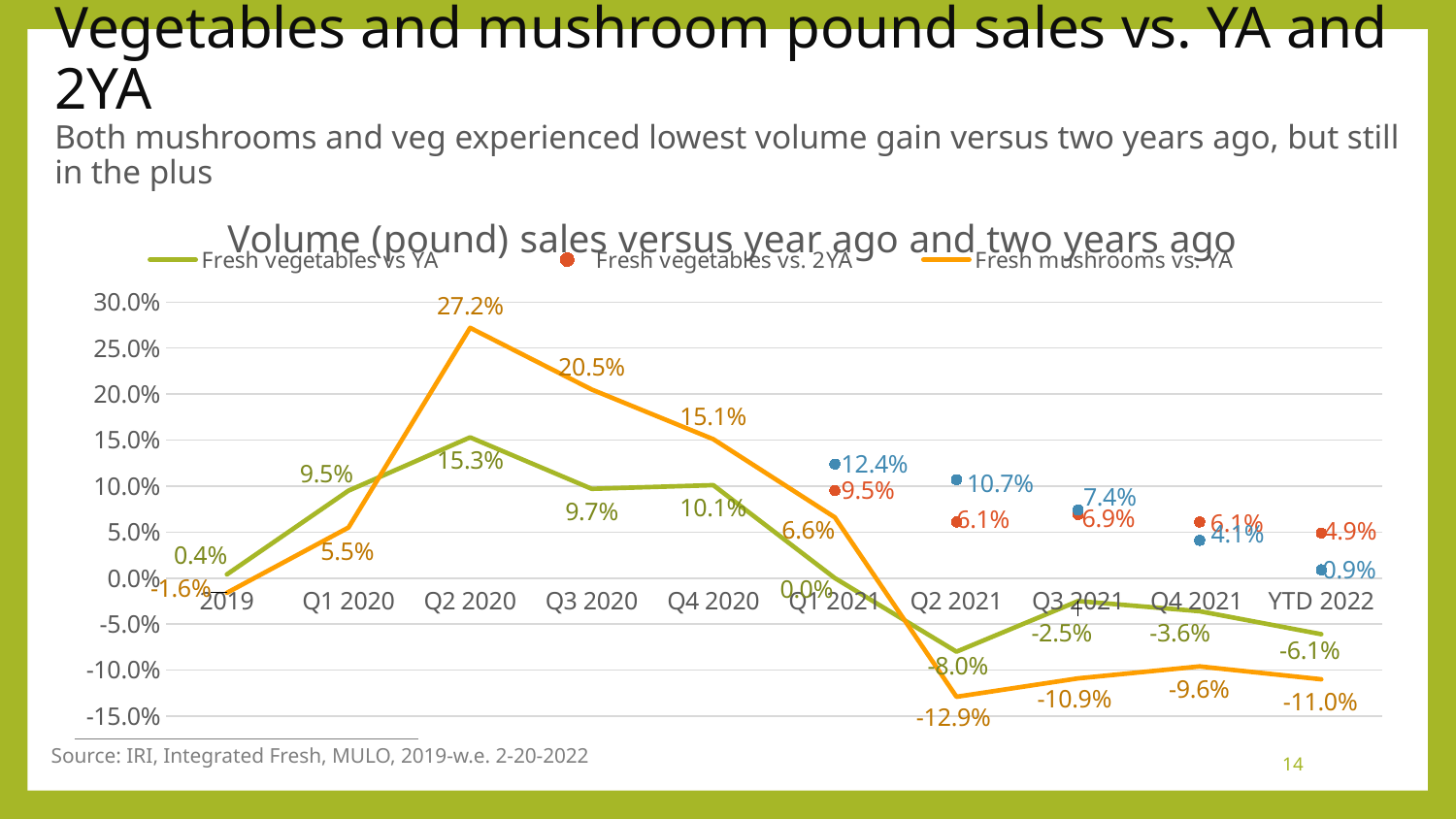
In which period is Fresh vegetables vs YA highest? Q2 2020 How many time periods are shown on the x axis? 10 What is the value for Fresh mushrooms vs. YA in Q2 2020? 27.2% In Q2 2020, how much higher is Fresh mushrooms vs. YA than Fresh vegetables vs YA? 11.9 percentage points In Q3 2020, which is larger: Fresh vegetables vs YA or Fresh mushrooms vs. YA? Fresh mushrooms vs. YA In which period is Fresh mushrooms vs. YA highest? Q2 2020 In which period is Fresh mushrooms vs. YA lowest? Q2 2021 What kind of chart is this? Line chart Does Fresh mushrooms vs. YA rise or fall from Q2 2020 to Q4 2020? Fall What is the value for Fresh vegetables vs YA in Q2 2020? 15.3% What is the value for Fresh vegetables vs. 2YA in YTD 2022? 4.9% In which period is Fresh vegetables vs YA lowest? Q2 2021